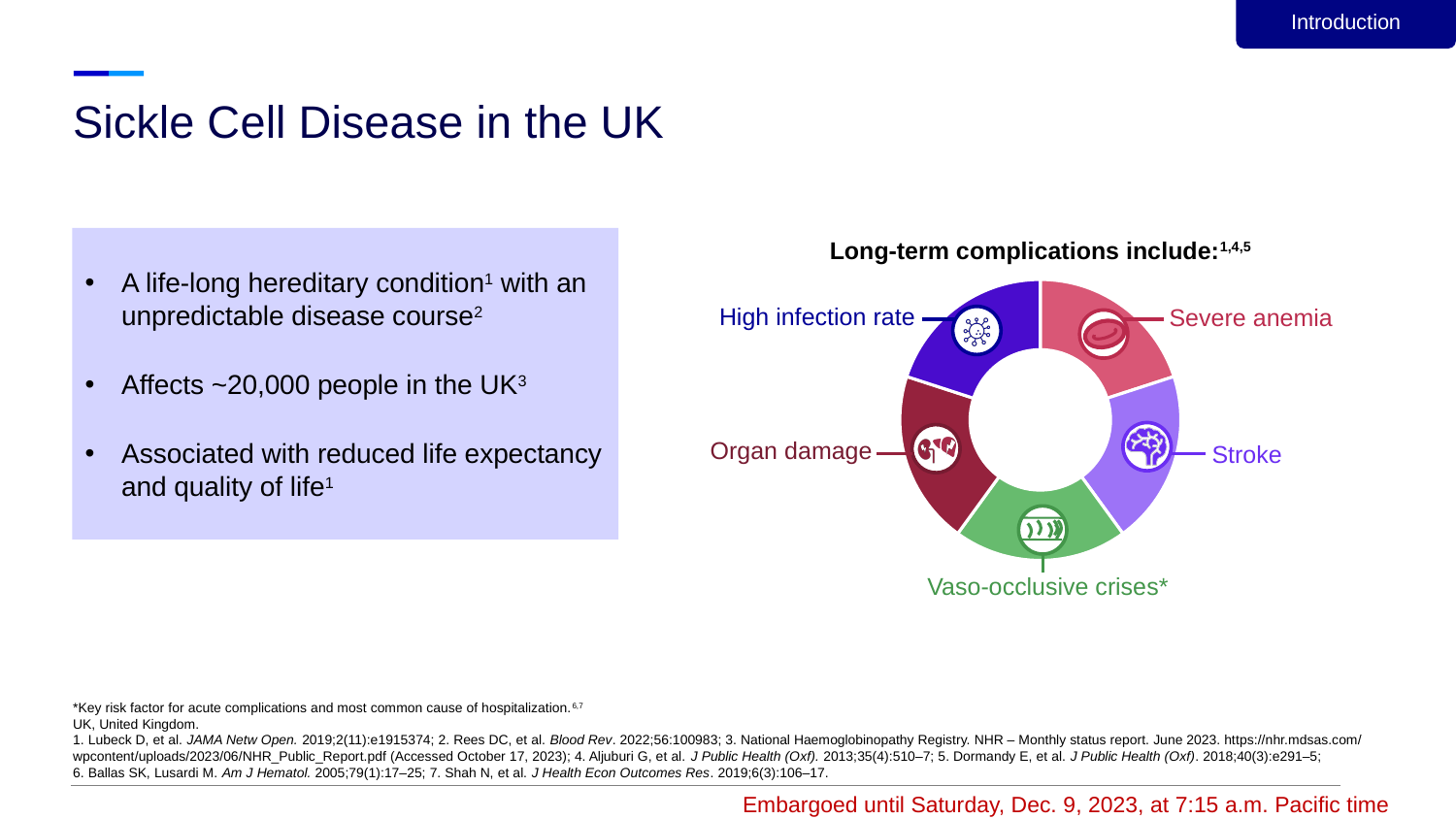
Which segment of the donut chart is marked with an asterisk? Vaso-occlusive crises* What kind of chart is shown on the slide? Donut (pie) chart Which complication is labelled at the bottom of the donut chart? Vaso-occlusive crises* Which complication is labelled to the right of the donut chart, opposite 'Organ damage'? Stroke Which complication is labelled at the top left of the donut chart? High infection rate Which complication is labelled at the top right of the donut chart? Severe anemia What is the title above the donut chart? Long-term complications include: How many segments does the donut chart have? 5